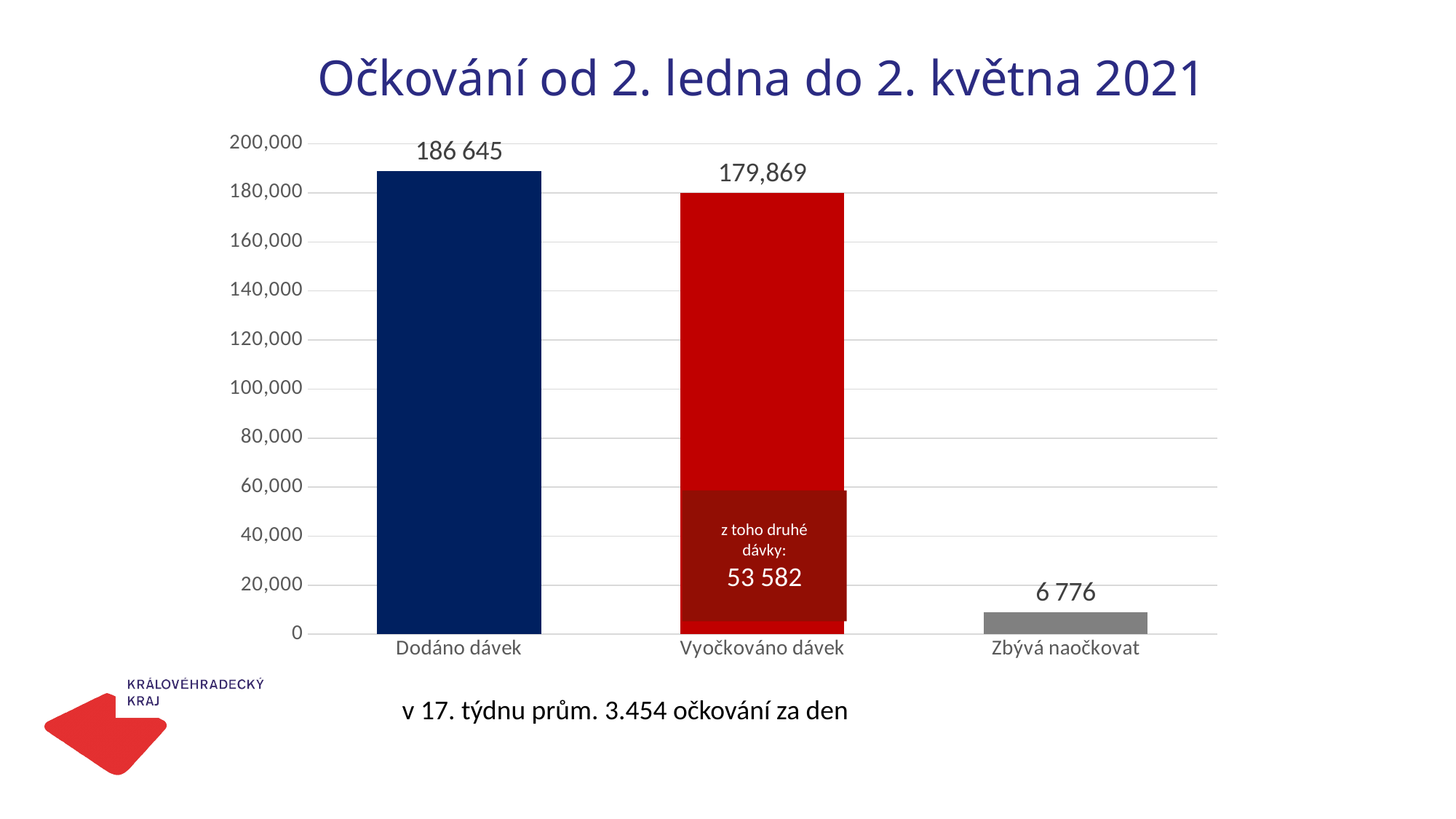
What is the value for Dodáno dávek? 186 645 Which category has the highest value? Dodáno dávek What is the difference between Dodáno dávek (186 645) and Vyočkováno dávek (179,869)? 6 776 Which category has the lowest value? Zbývá naočkovat What is the title of the chart? Očkování od 2. ledna do 2. května 2021 What is the value for Vyočkováno dávek? 179,869 Is the value for Zbývá naočkovat greater or less than 20,000? less What is the value for Zbývá naočkovat? 6 776 What type of chart is shown on the slide? bar chart Which is larger, Dodáno dávek or Vyočkováno dávek? Dodáno dávek How many categories are shown on the x axis? 3 How many second doses (druhé dávky) are shown within the Vyočkováno dávek bar? 53 582